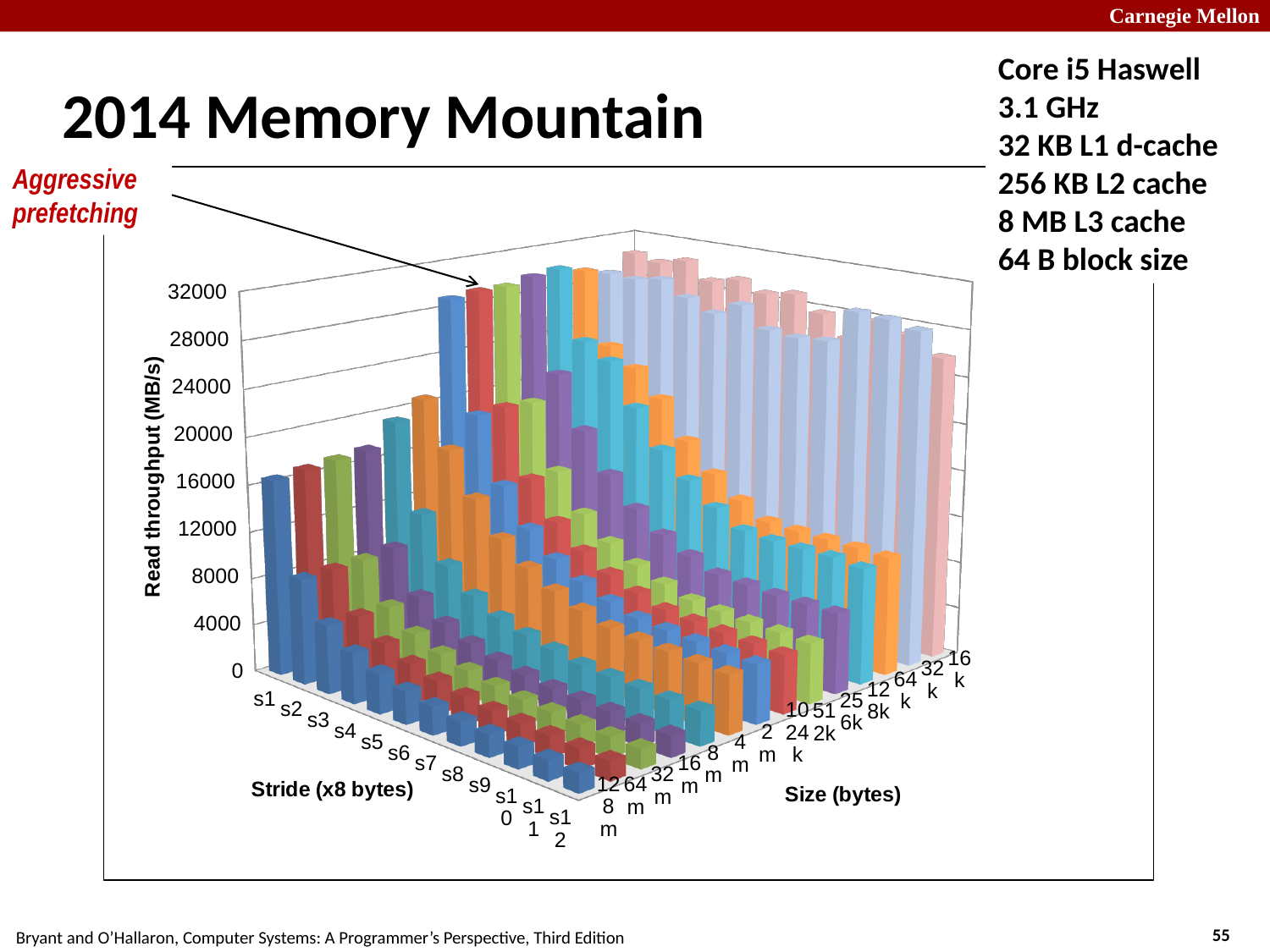
Is the read throughput for stride s1 at size 128m greater or less than 24000? less Is the read throughput for stride s1 at size 16k greater or less than 28000? greater Is the read throughput for stride s12 at size 128m greater or less than 4000? less How many size categories are shown along the Size (bytes) axis? 14 What is the title of the chart on the slide? 2014 Memory Mountain For size 128m, does read throughput rise or fall as the stride increases from s1 to s12? fall How many stride categories (s1 through s12) are shown along the stride axis? 12 For stride s1, which size has the higher read throughput: 128m or 16k? 16k What kind of chart is shown on the slide? 3D bar chart What is the highest tick value shown on the Read throughput axis? 32000 What is the label of the vertical axis of the chart? Read throughput (MB/s) For stride s1, does read throughput rise or fall as the size decreases from 128m to 16k? rise